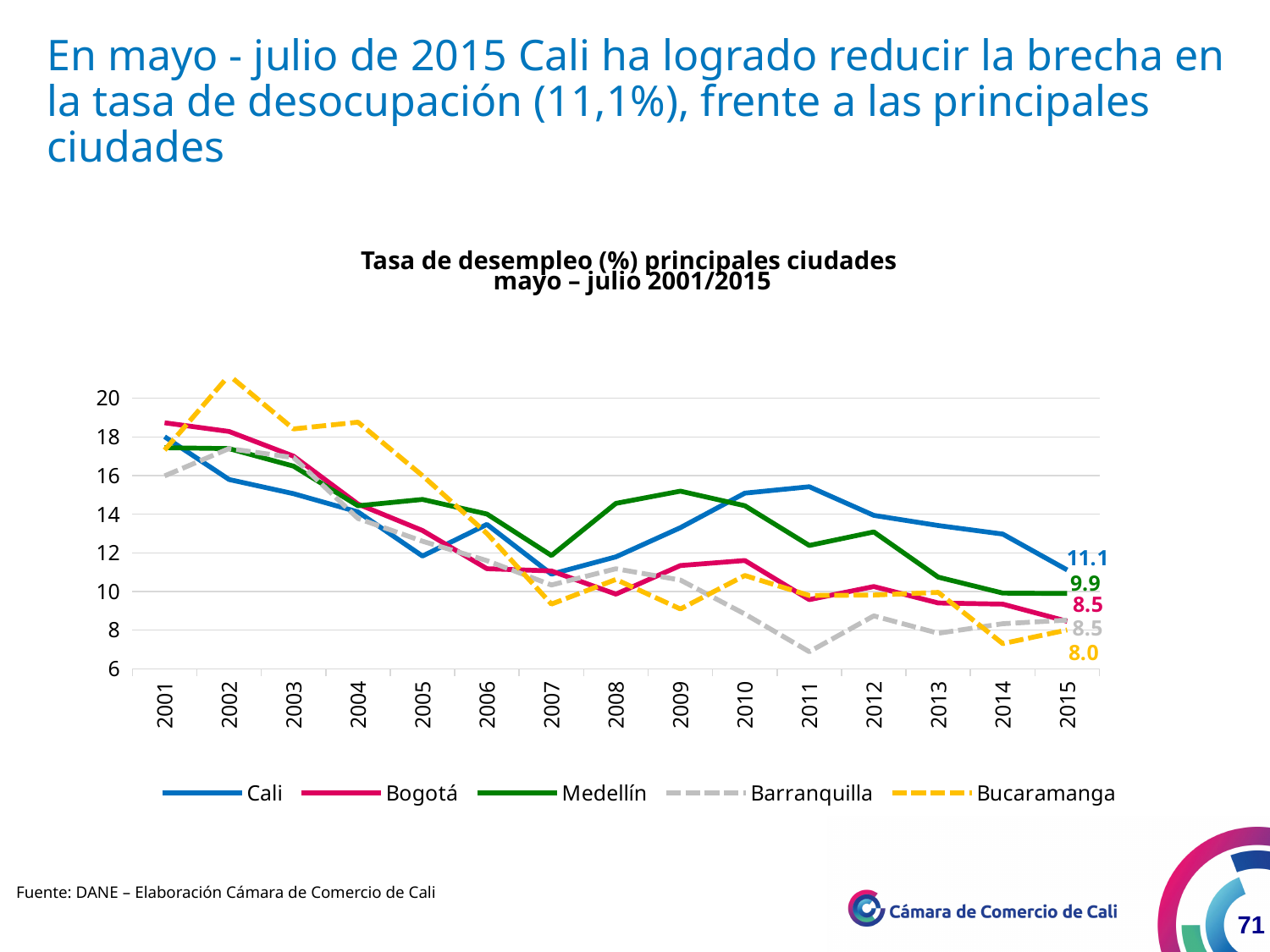
Which city has the lowest unemployment rate in 2015? Bucaramanga How many years are shown on the x axis? 15 How many series does the legend list? 5 Is the value for Barranquilla in 2011 greater or less than 8? less Is the value for Bucaramanga in 2002 greater or less than 20? greater What value is labelled for Bucaramanga in 2015? 8.0 What kind of chart is shown on the slide? line chart What is the unemployment rate for Cali in 2015 according to the data label? 11.1 Which city has the highest unemployment rate in 2015? Cali What is the difference between the 2015 values for Cali and Medellín? 1.2 In 2015, which is larger: the value for Medellín or the value for Bogotá? Medellín What value is labelled for Medellín in 2015? 9.9